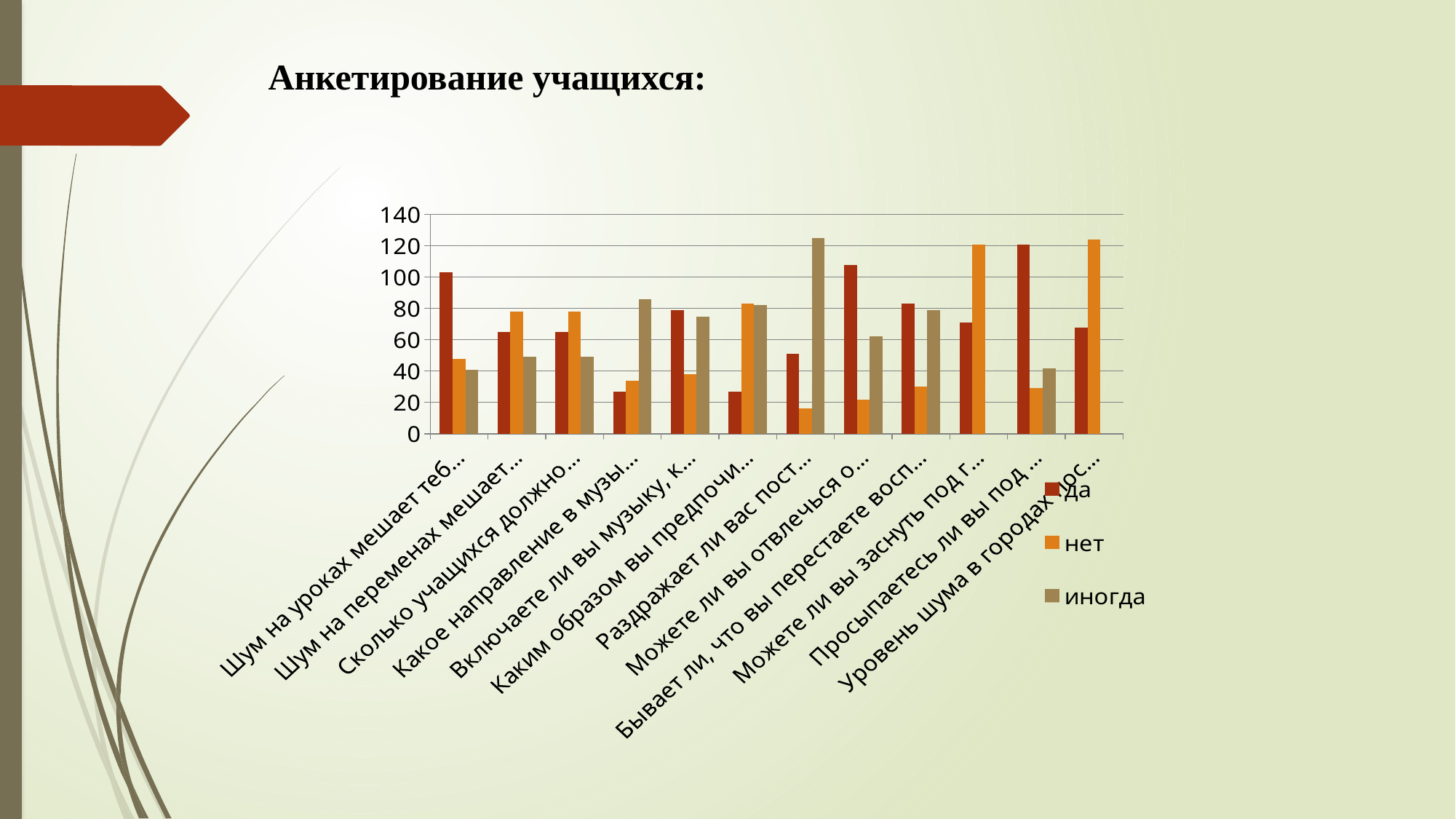
For 'Шум на уроках мешает теб...', which is larger: the 'да' bar or the 'нет' bar? да Which series has the highest bar for 'Можете ли вы отвлечься о...'? да What are the series names listed in the legend? да, нет, иногда Is the value of the 'иногда' series for 'Раздражает ли вас пост...' greater or less than 100? greater How many categories are plotted along the x axis? 12 Is the value of the 'да' series for 'Шум на уроках мешает теб...' greater or less than 80? greater What kind of chart is shown on the slide? bar chart Is the value of the 'нет' series for 'Раздражает ли вас пост...' greater or less than 20? less What is the title of the slide above the chart? Анкетирование учащихся: For 'Какое направление в музы...', which is larger: the 'да' bar or the 'иногда' bar? иногда How many series does the legend list? 3